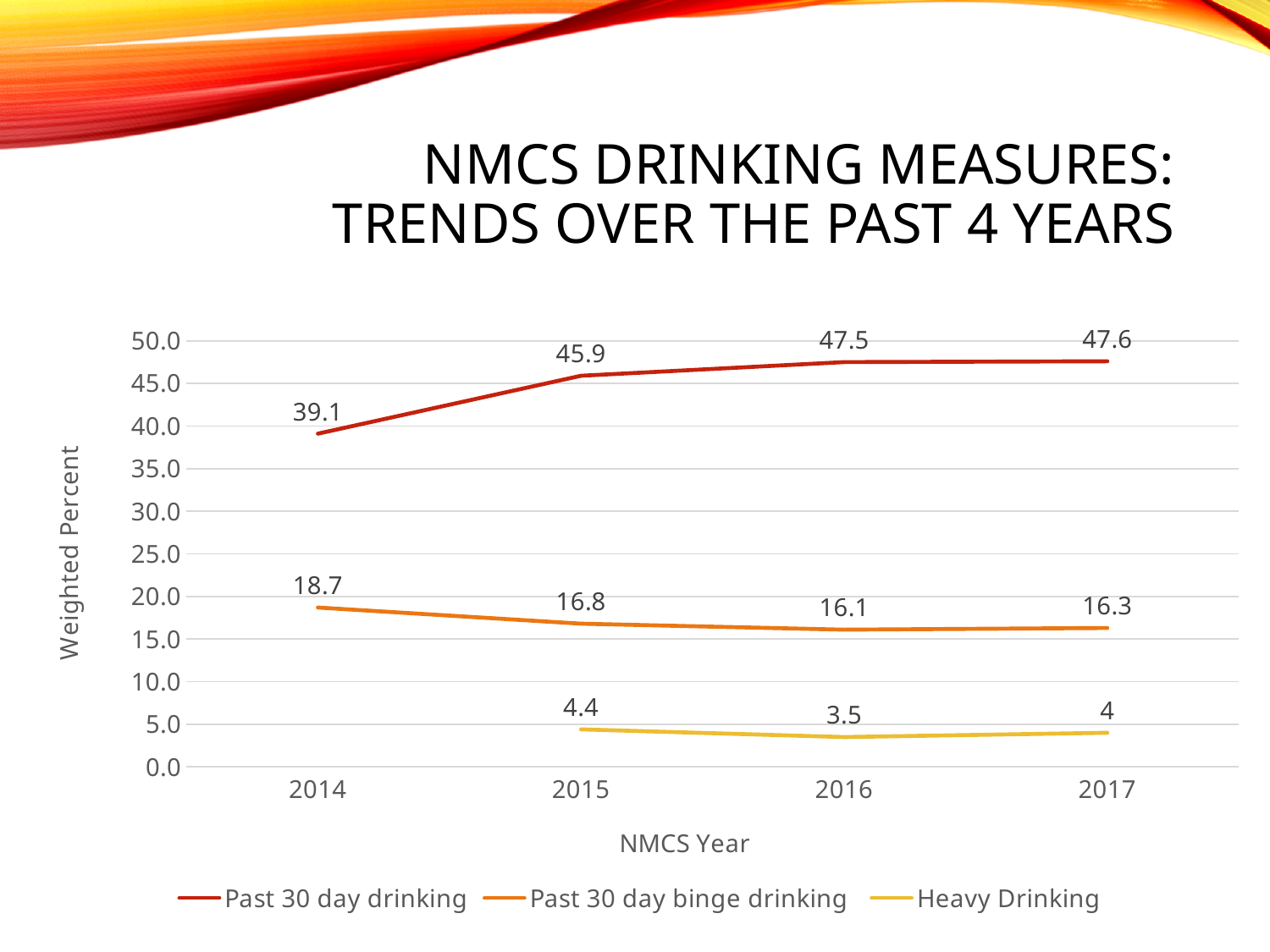
What is the value for Past 30 day binge drinking in 2016? 16.1 What kind of chart is shown on the slide? line chart Which is larger: Past 30 day binge drinking in 2015 or in 2017? 2015 In which year is Past 30 day binge drinking lowest? 2016 Is the value for Past 30 day drinking in 2016 greater or less than 45.0? greater How many series does the legend list? 3 What is the difference between Past 30 day drinking in 2017 and 2014? 8.5 How many years are shown on the x axis? 4 What is the value for Heavy Drinking in 2015? 4.4 What is the value for Past 30 day drinking in 2014? 39.1 In which year is Past 30 day drinking highest? 2017 Does Past 30 day drinking rise or fall from 2014 to 2017? rise